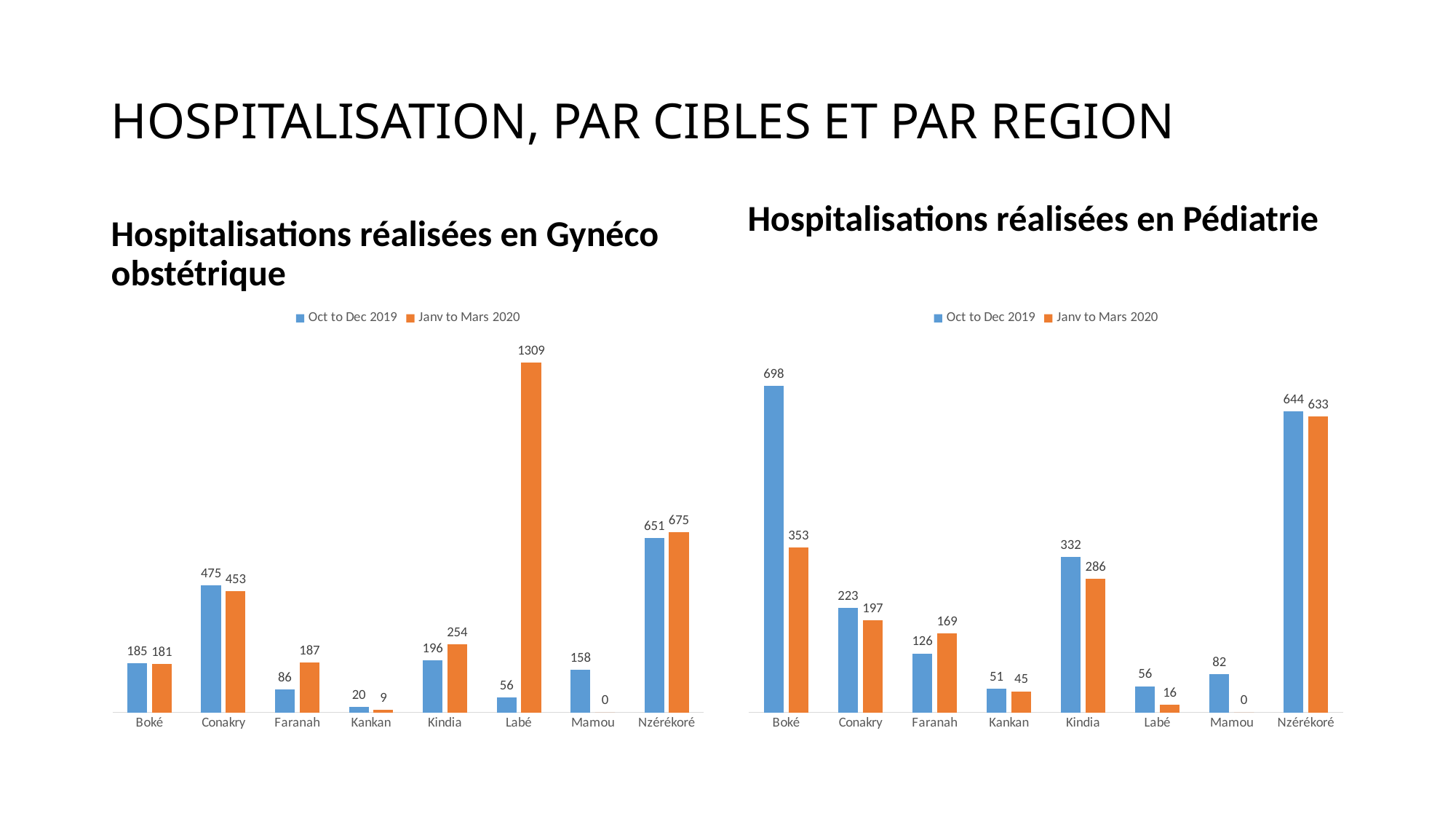
In the 'Hospitalisations réalisées en Gynéco obstétrique' chart, what is the value for Mamou in Janv to Mars 2020? 0 Which colour represents the Janv to Mars 2020 series in both charts? Orange In the 'Hospitalisations réalisées en Pédiatrie' chart, what is the value for Boké in Oct to Dec 2019? 698 In the 'Hospitalisations réalisées en Gynéco obstétrique' chart, which region has the highest value for Oct to Dec 2019? Nzérékoré In the 'Hospitalisations réalisées en Gynéco obstétrique' chart, which is larger for Kindia: Oct to Dec 2019 or Janv to Mars 2020? Janv to Mars 2020 How many series does the legend of the 'Hospitalisations réalisées en Gynéco obstétrique' chart list? 2 In the 'Hospitalisations réalisées en Pédiatrie' chart, what is the difference between Kindia's Oct to Dec 2019 value and its Janv to Mars 2020 value? 46 In the 'Hospitalisations réalisées en Pédiatrie' chart, which region has the lowest value for Janv to Mars 2020? Mamou In the 'Hospitalisations réalisées en Gynéco obstétrique' chart, what is the value for Labé in Janv to Mars 2020? 1309 How many regions are shown on the x axis of the 'Hospitalisations réalisées en Pédiatrie' chart? 8 In the 'Hospitalisations réalisées en Pédiatrie' chart, what is the difference between the Oct to Dec 2019 and Janv to Mars 2020 values for Boké? 345 What kind of chart is the 'Hospitalisations réalisées en Pédiatrie' chart? Bar chart